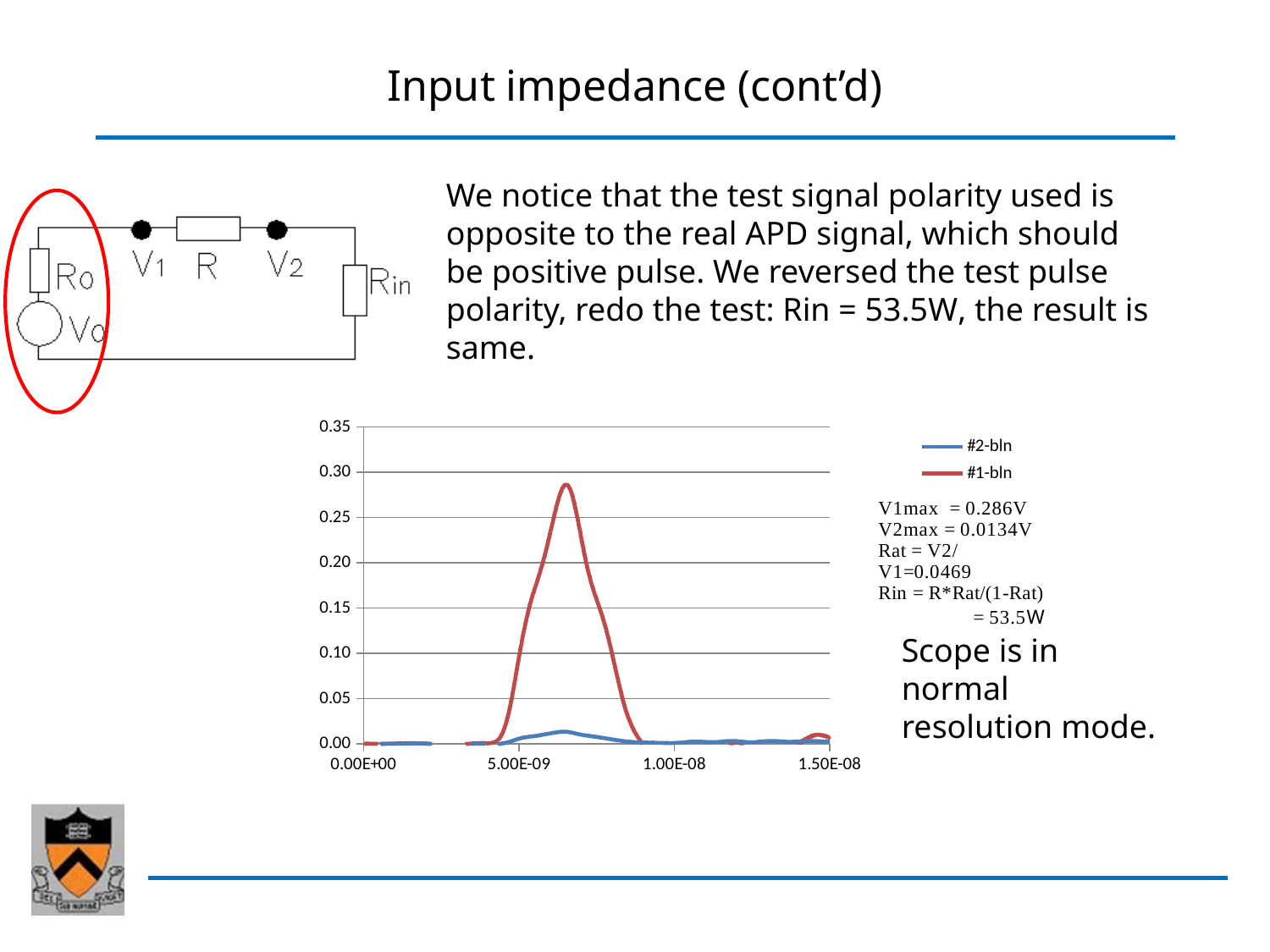
Which series reaches the higher peak value, #1-bln or #2-bln? #1-bln How many series does the chart legend list? 2 Is the peak of the #1-bln series located before or after 1.00E-08 on the horizontal axis? before Which colour is used for the #1-bln series in the chart? red What kind of chart is shown on the slide? line chart What are the names of the two series in the chart legend? #2-bln and #1-bln Is the peak value of the #1-bln series greater or less than 0.30? less Does the #1-bln series rise or fall between 5.00E-09 and its peak? rise Is the peak value of the #1-bln series greater or less than 0.25? greater Is the peak value of the #2-bln series greater or less than 0.05? less What is the highest tick value shown on the chart's vertical axis? 0.35